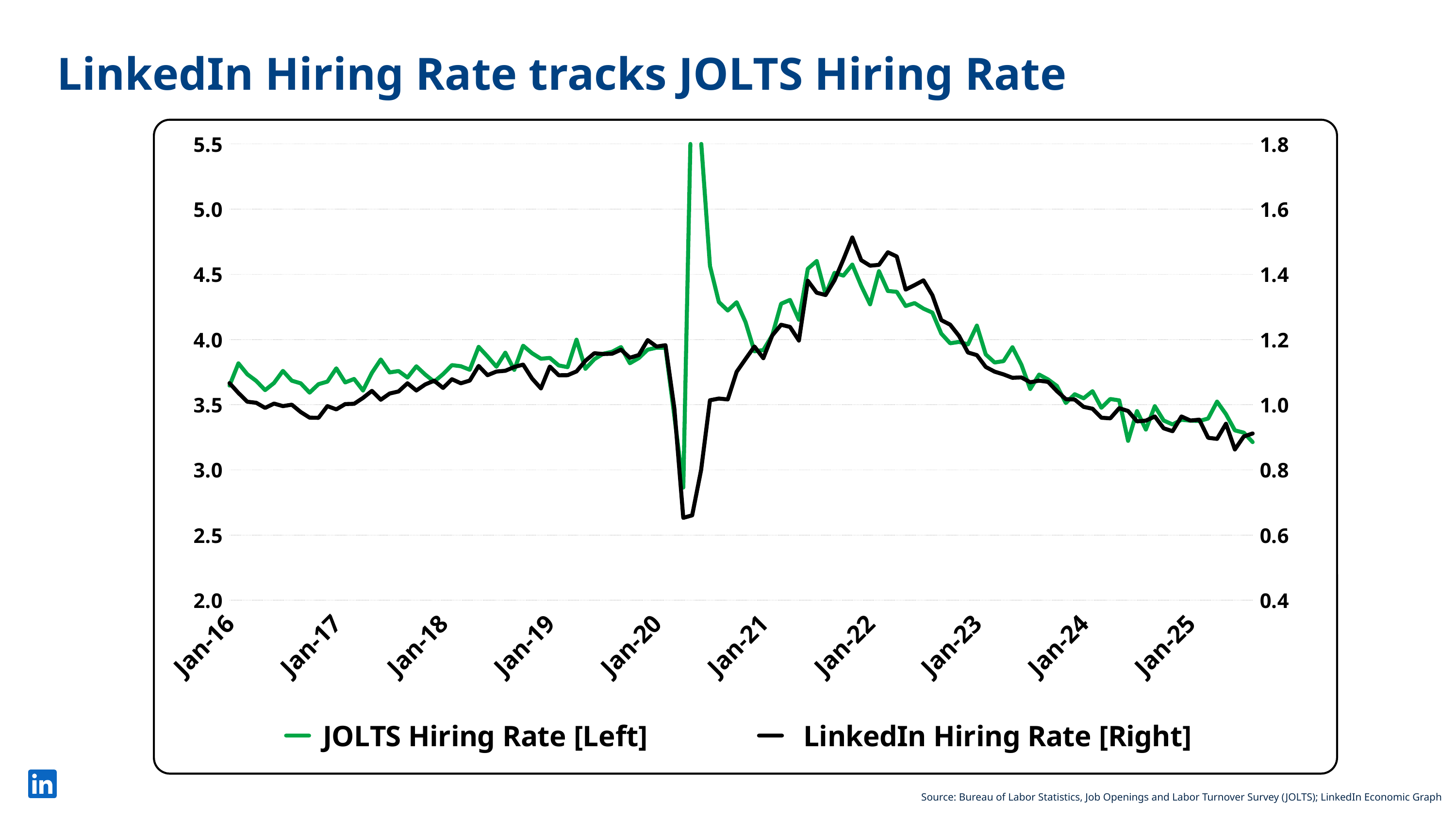
Is the peak of the JOLTS Hiring Rate in 2020 greater or less than 5.0? greater Between Jan-22 and Jan-25, does the LinkedIn Hiring Rate generally rise or fall? fall How many series does the legend list? 2 In which year does the LinkedIn Hiring Rate reach its lowest point? 2020 In which year does the JOLTS Hiring Rate reach its highest point? 2020 Is the lowest value of the LinkedIn Hiring Rate, reached in 2020, greater or less than 0.8? less What kind of chart is shown on the slide? line chart Is the LinkedIn Hiring Rate at the end of the series (after Jan-25) greater or less than 1.0? less Which series is plotted against the right-hand axis? LinkedIn Hiring Rate What colour is the JOLTS Hiring Rate line? green